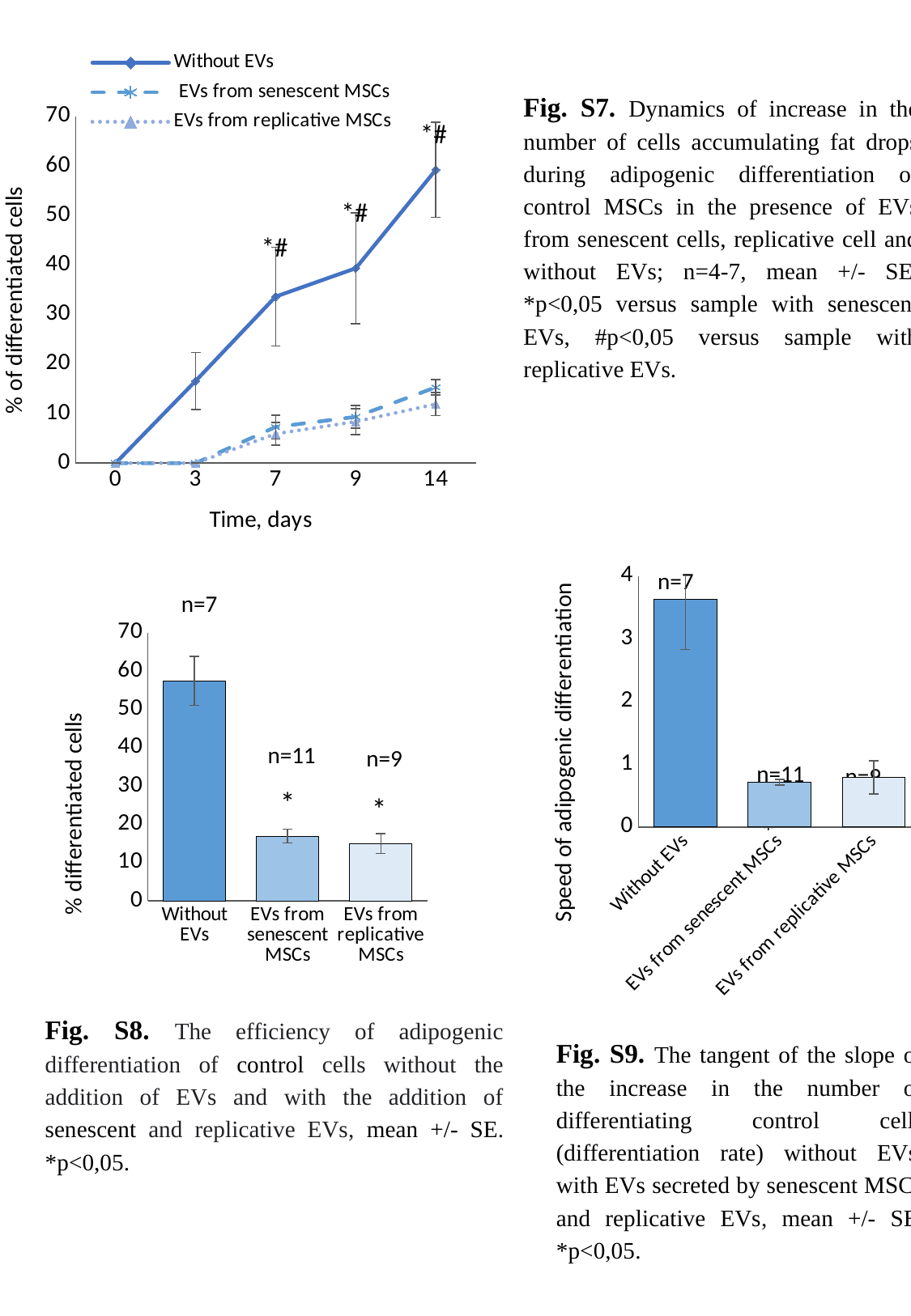
What kind of chart is the bottom-left chart (Fig. S8)? bar chart In the bottom-right bar chart (Fig. S9), which is larger: the value for Without EVs or the value for EVs from senescent MSCs? Without EVs In the bottom-left bar chart (Fig. S8), is the value for EVs from senescent MSCs greater or less than 20? less In the bottom-left bar chart (Fig. S8), what n value is printed above the Without EVs bar? n=7 In the top-left line chart (Fig. S7), how many series does the legend list? 3 In the bottom-right bar chart (Fig. S9), is the value for Without EVs greater or less than 3? greater In the top-left line chart (Fig. S7), is the value for Without EVs at day 14 greater or less than 50? greater In the top-left line chart (Fig. S7), does the Without EVs series rise or fall from day 0 to day 14? rise In the bottom-left bar chart (Fig. S8), which category has the highest % of differentiated cells? Without EVs What kind of chart is the top-left chart (Fig. S7) showing % of differentiated cells over time? line chart In the top-left line chart (Fig. S7), which series has the highest value at day 14? Without EVs In the top-left line chart (Fig. S7), how many time points are marked on the x axis? 5